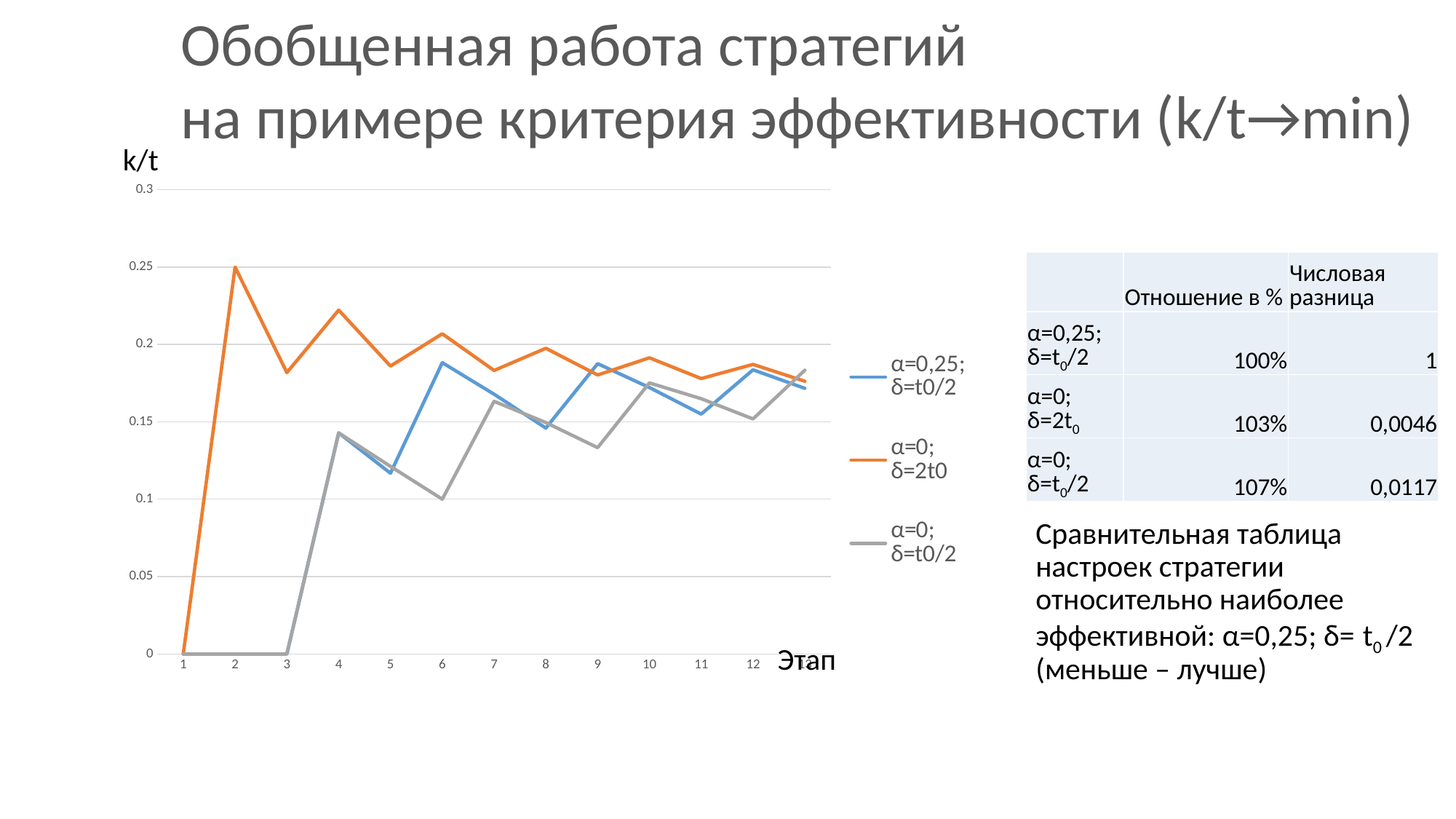
How many series does the chart legend list? 3 At stage 6, which series has the larger value: α=0,25; δ=t0/2 or α=0; δ=t0/2? α=0,25; δ=t0/2 What is the label on the vertical axis of the chart? k/t What is the value of the α=0; δ=2t0 series at stage 1? 0 Is the value of the α=0; δ=t0/2 series at stage 6 greater or less than 0.15? less Which series has the highest value at stage 2? α=0; δ=2t0 Does the α=0; δ=2t0 series rise or fall from stage 2 to stage 3? fall Is the value of the α=0; δ=t0/2 series at stage 4 greater or less than 0.1? greater What is the value of the α=0; δ=t0/2 series at stage 3? 0 What kind of chart is shown on the slide? line chart Is the value of the α=0,25; δ=t0/2 series at stage 5 greater or less than 0.15? less